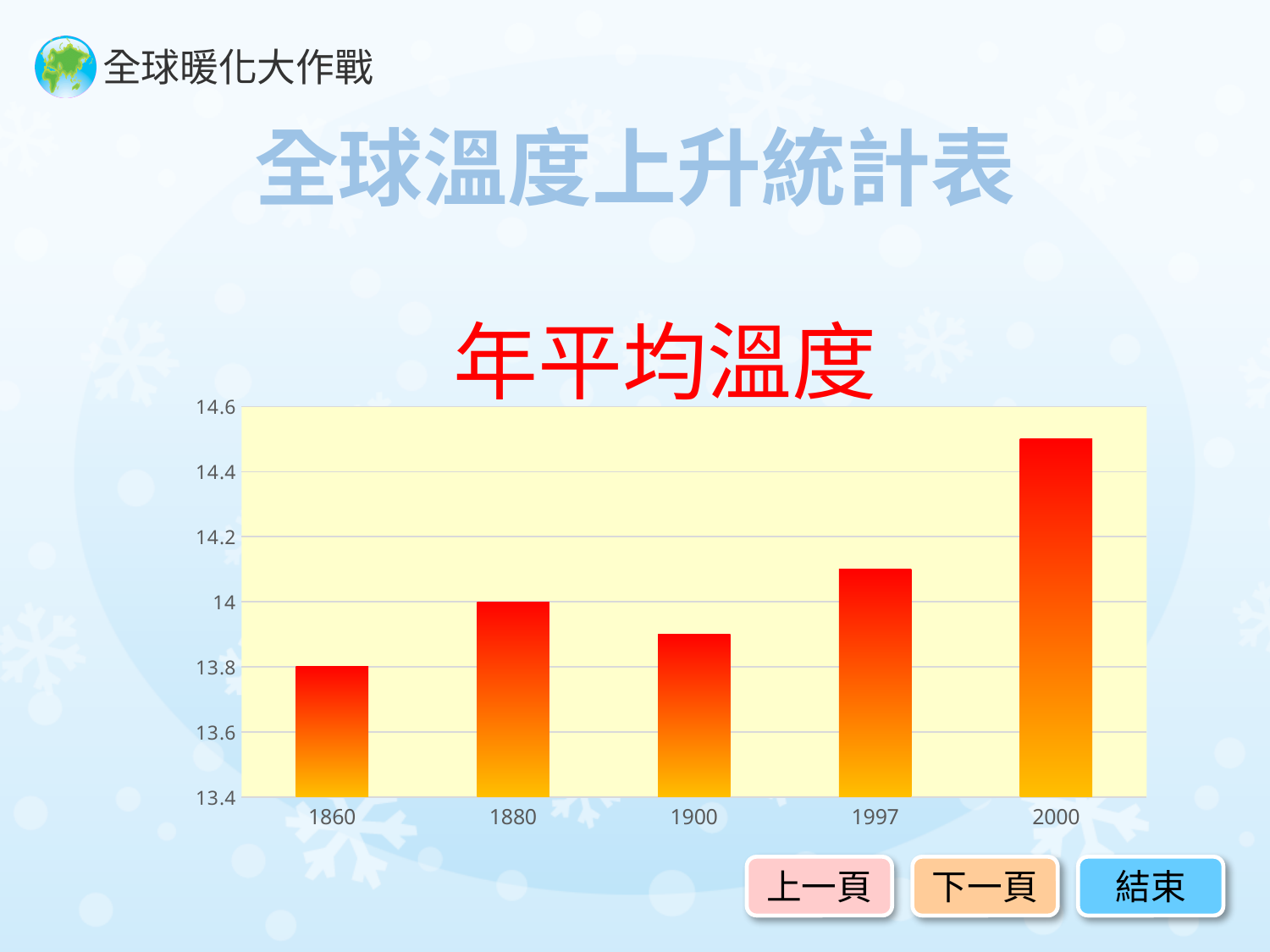
What is the title of the chart? 年平均溫度 How many years are shown on the x axis of the chart? 5 Which is larger, the value for 1880 or the value for 1900? 1880 Is the value for 1997 greater or less than 14? greater Is the value for 1900 greater or less than 14? less What kind of chart is shown on the slide? bar chart Which year has the highest bar in the 年平均溫度 chart? 2000 Is the value for 2000 greater or less than 14.4? greater What is the value for 1880 in the 年平均溫度 chart? 14 Which year has the lowest bar in the 年平均溫度 chart? 1860 What is the difference between the values for 1880 and 1860? 0.2 What is the value for 1860 in the 年平均溫度 chart? 13.8